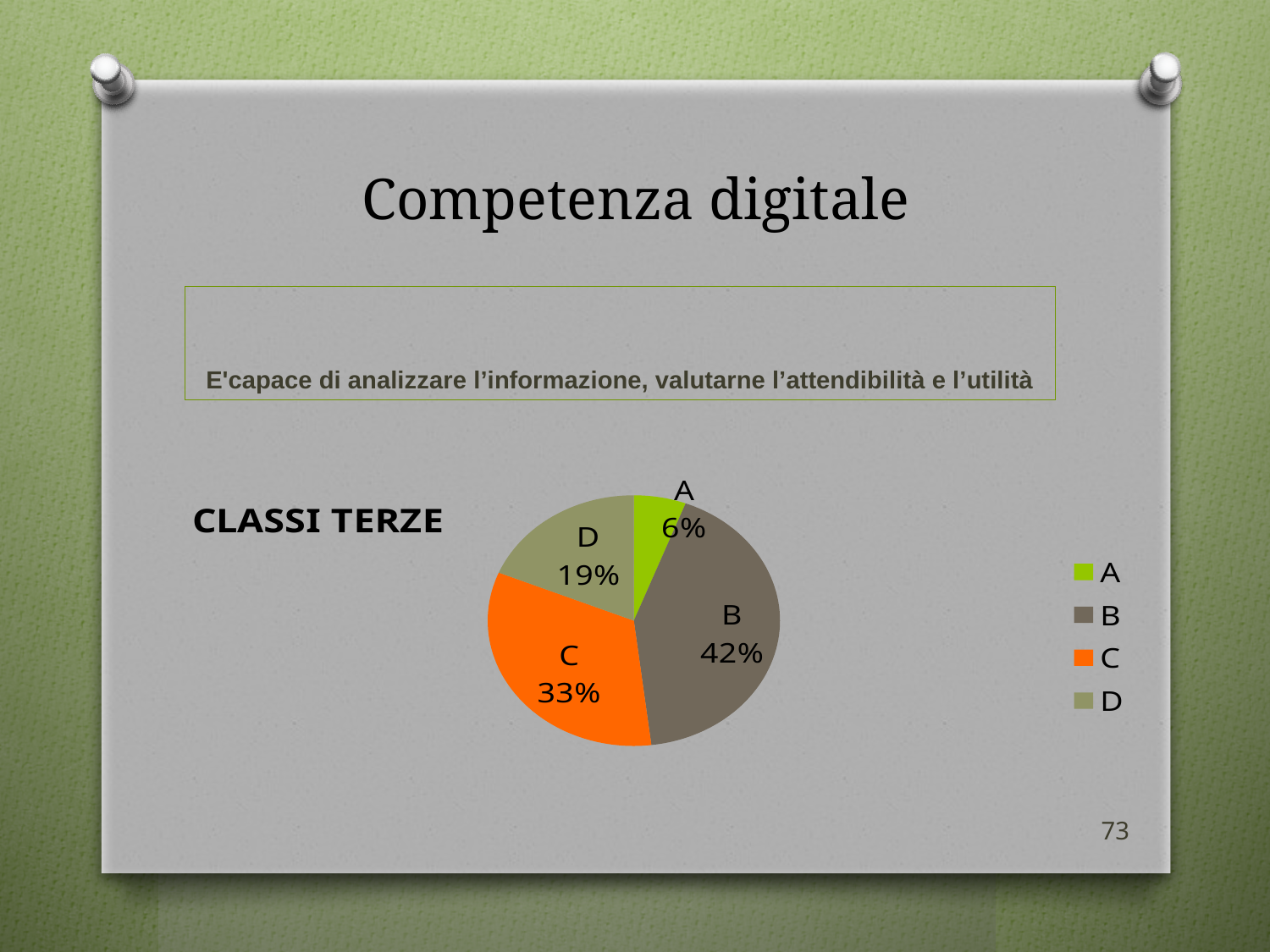
What percentage of the pie does slice A represent? 6% What percentage of the pie does slice D represent? 19% Which slice is the largest in the pie chart? B How many entries does the legend list? 4 Which slice is the smallest in the pie chart? A How many slices does the pie chart have? 4 What kind of chart is shown on the slide? pie chart Which is larger, slice C or slice D? C What percentage of the pie does slice B represent? 42% What colour is slice C in the pie chart? orange What is the difference in percentage points between slice B and slice C? 9 What percentage of the pie does slice C represent? 33%